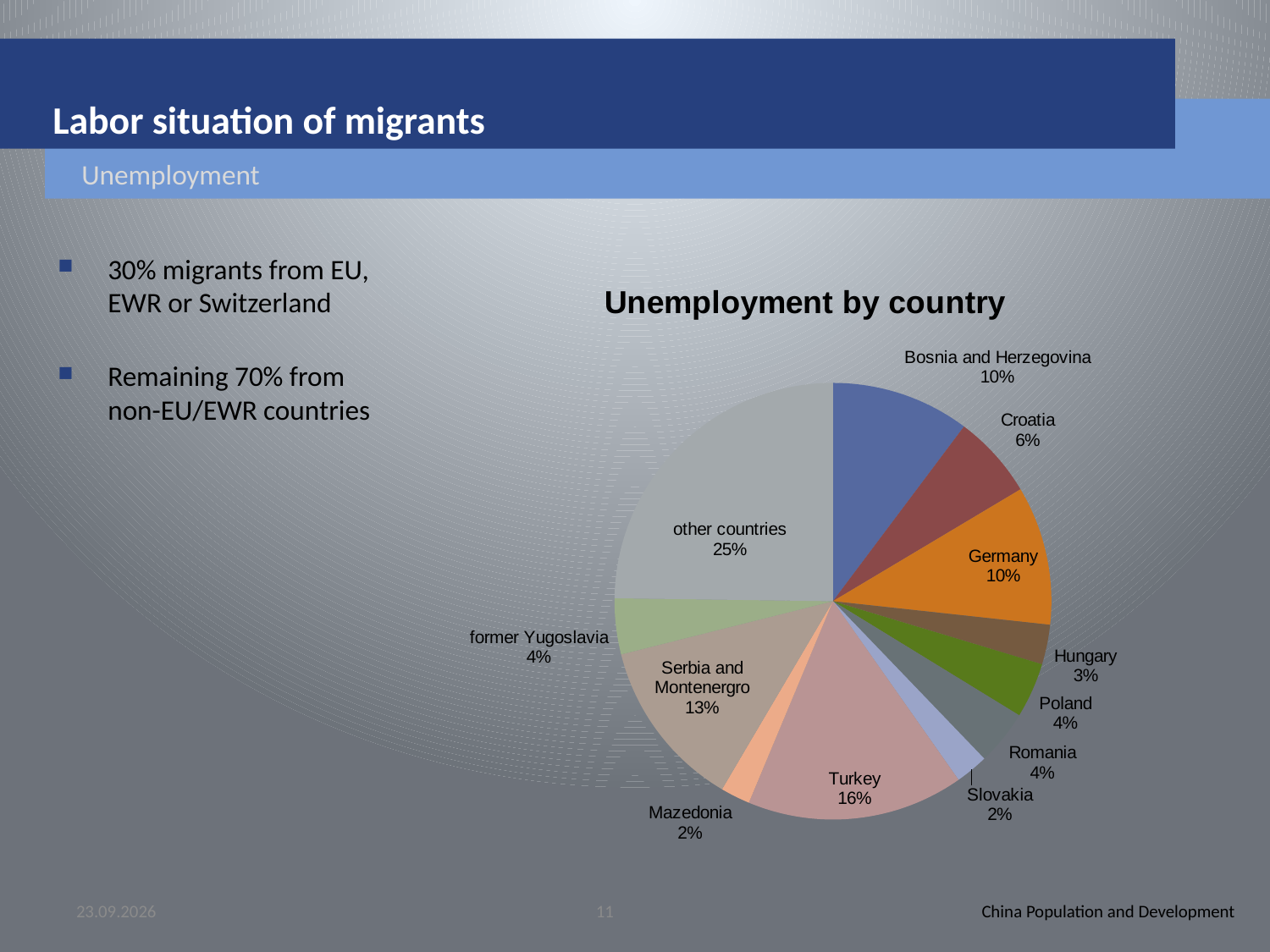
What is the value shown for Serbia and Montenergro? 13% What kind of chart is shown on the slide? pie chart What share of the pie does Turkey account for? 16% Which is larger, the slice for Germany or the slice for Poland? Germany How many categories (slices) does the pie chart have? 12 Which category has the largest slice of the pie? other countries What is the value shown for Hungary? 3% What is the difference between the values for other countries and Serbia and Montenergro? 12% What is the difference between the values for Turkey and Bosnia and Herzegovina? 6% What is the title of the chart? Unemployment by country What is the value shown for Slovakia? 2% What is the value shown for Croatia? 6%